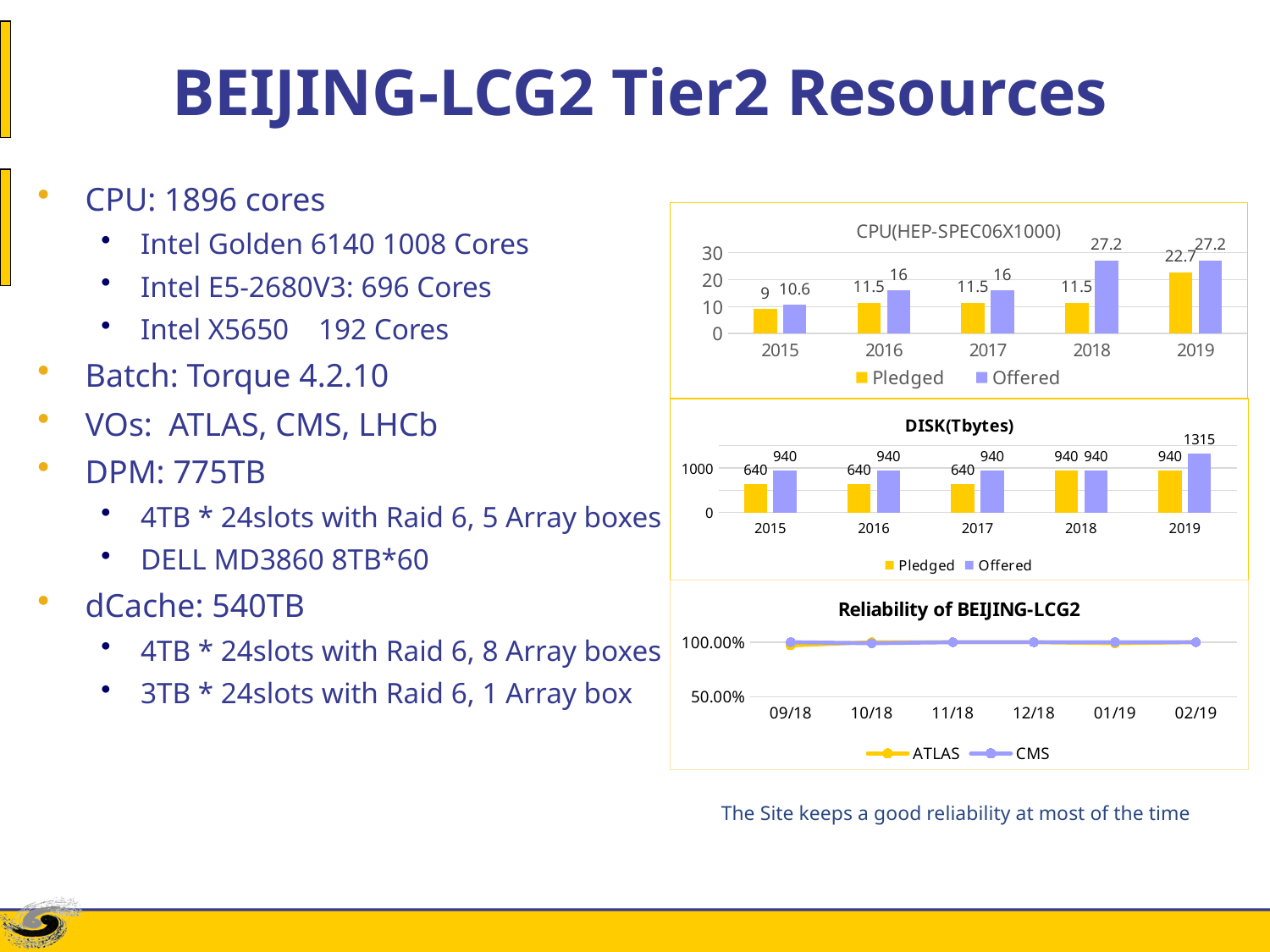
In the CPU(HEP-SPEC06X1000) chart, how many years are shown on the x axis? 5 In the DISK(Tbytes) chart, which year has the highest Offered value? 2019 In the CPU(HEP-SPEC06X1000) chart, what is the difference between the Offered and Pledged values for 2018? 15.7 In the CPU(HEP-SPEC06X1000) chart, which year has the lowest Pledged value? 2015 In the CPU(HEP-SPEC06X1000) chart, what is the Pledged value for 2019? 22.7 In the DISK(Tbytes) chart, is the Pledged value for 2018 larger or smaller than the Pledged value for 2017? larger In the DISK(Tbytes) chart, what is the difference between the Offered and Pledged values for 2015? 300 What kind of chart is the Reliability of BEIJING-LCG2 chart? line chart In the DISK(Tbytes) chart, what is the Pledged value for 2016? 640 How many series does the legend of the Reliability of BEIJING-LCG2 chart list? 2 In the DISK(Tbytes) chart, what is the Offered value for 2019? 1315 In the CPU(HEP-SPEC06X1000) chart, what is the Offered value for 2018? 27.2